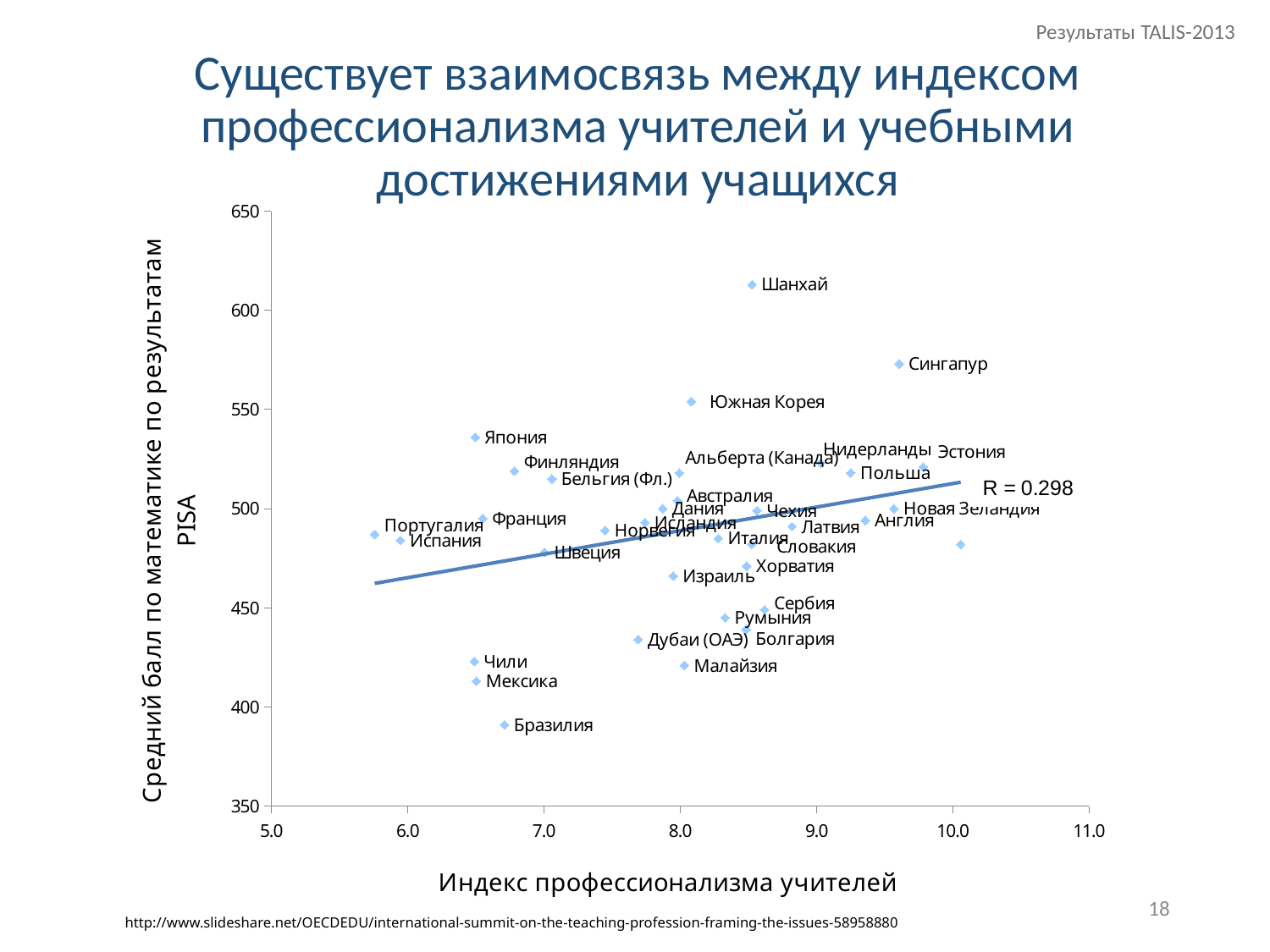
Is the teacher professionalism index for Португалия greater or less than 6.0? less What kind of chart is shown on the slide? Scatter chart What correlation coefficient R is shown on the chart? R = 0.298 Does the fitted trend line rise or fall as the teacher professionalism index increases? rises Which country has the lowest average PISA mathematics score on the chart? Бразилия Which has the higher PISA score, Япония or Финляндия? Япония Which has the higher PISA score, Шанхай or Сингапур? Шанхай Which country has the highest average PISA mathematics score on the chart? Шанхай Is the PISA score for Бразилия greater or less than 400? less Is the PISA score for Сингапур greater or less than 550? greater Which labelled country has the lowest teacher professionalism index on the chart? Португалия